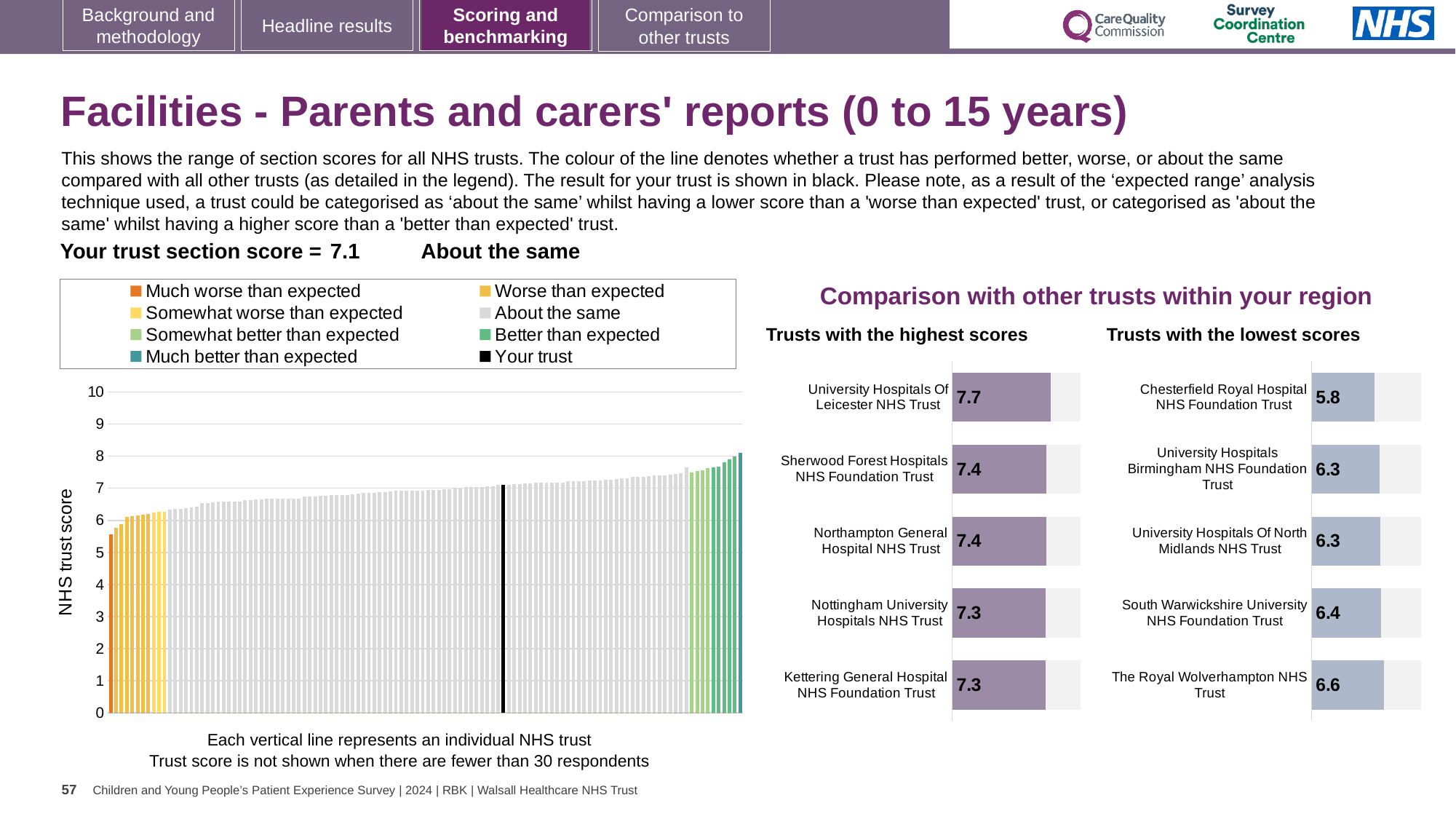
In the 'Trusts with the highest scores' chart, what is the difference between the scores of University Hospitals Of Leicester NHS Trust and Kettering General Hospital NHS Foundation Trust? 0.4 In the 'Trusts with the lowest scores' chart, which has the larger score: Chesterfield Royal Hospital NHS Foundation Trust or South Warwickshire University NHS Foundation Trust? South Warwickshire University NHS Foundation Trust How many entries does the legend of the large chart on the left list? 8 In the 'Trusts with the highest scores' chart, what is the score for University Hospitals Of Leicester NHS Trust? 7.7 In the 'Trusts with the lowest scores' chart, which trust has the lowest score? Chesterfield Royal Hospital NHS Foundation Trust In the 'Trusts with the lowest scores' chart, which trust has the highest score? The Royal Wolverhampton NHS Trust In the 'Trusts with the lowest scores' chart, what is the score for Chesterfield Royal Hospital NHS Foundation Trust? 5.8 In the 'Trusts with the lowest scores' chart, what is the difference between the scores of The Royal Wolverhampton NHS Trust and Chesterfield Royal Hospital NHS Foundation Trust? 0.8 In the large chart on the left, is the value of the lowest (leftmost) bar greater or less than 6? less What is the y-axis label of the large chart on the left? NHS trust score In the 'Trusts with the highest scores' chart, which trust has the highest score? University Hospitals Of Leicester NHS Trust How many trusts are shown in the 'Trusts with the highest scores' chart? 5